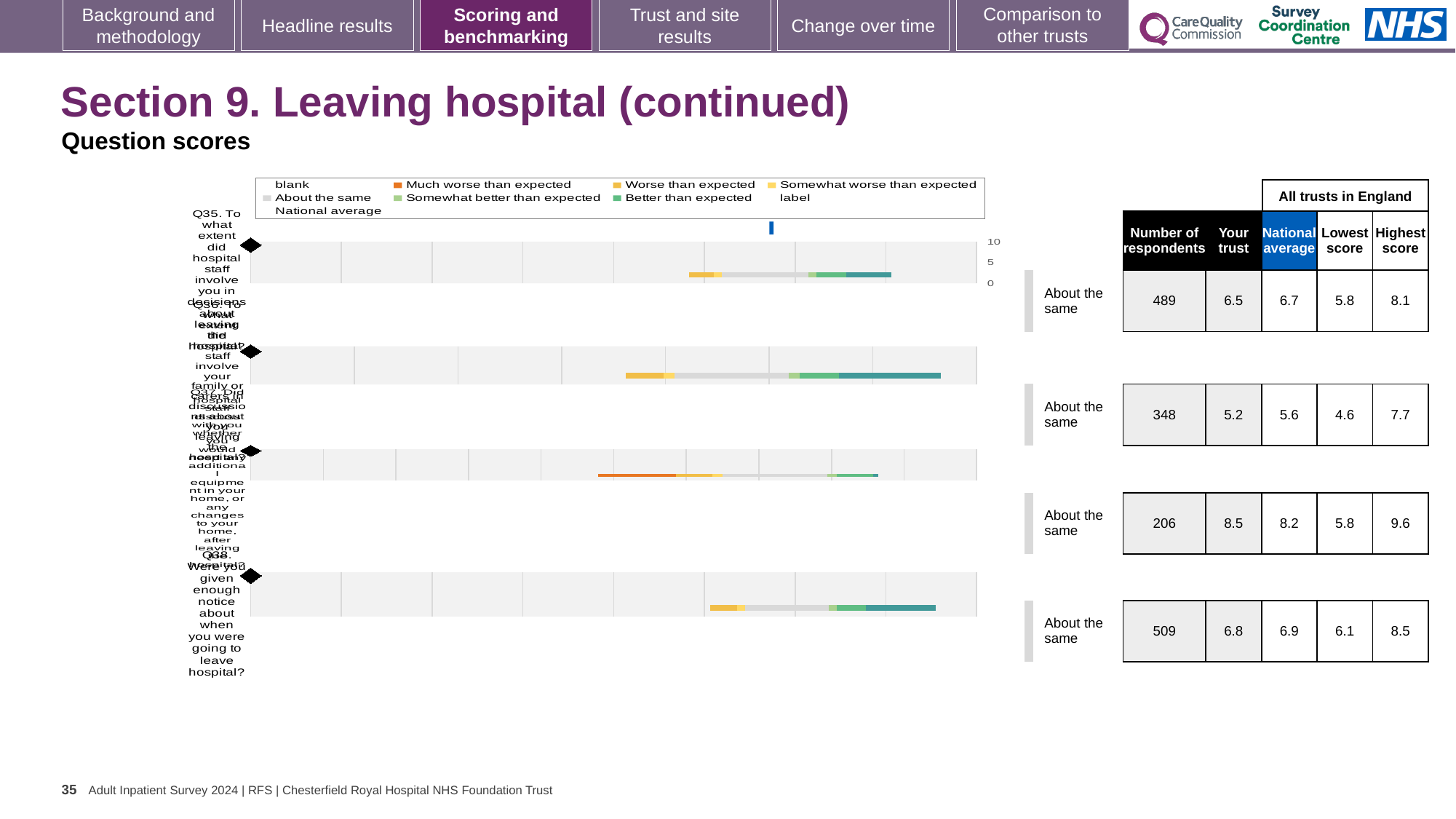
How many horizontal bars are plotted in the chart? 4 Which row of the table has the lowest number of respondents? the third row (206) In the third row of the table, what is the difference between the 'Your trust' score (8.5) and the national average (8.2)? 0.3 In the table next to the chart, what is the highest score in the third row? 9.6 What colour represents 'Much worse than expected' in the chart legend? orange In the table next to the chart, what is the number of respondents in the first row? 489 What kind of chart is shown on the slide? bar chart In the third row of the table, which is larger: the 'Your trust' score or the national average? Your trust Which bar in the chart shows an orange 'Much worse than expected' segment? the third bar from the top Which row of the table has the highest number of respondents? the fourth row (509) In the table next to the chart, what is the 'Your trust' score in the first row? 6.5 How many entries does the chart legend list? 9